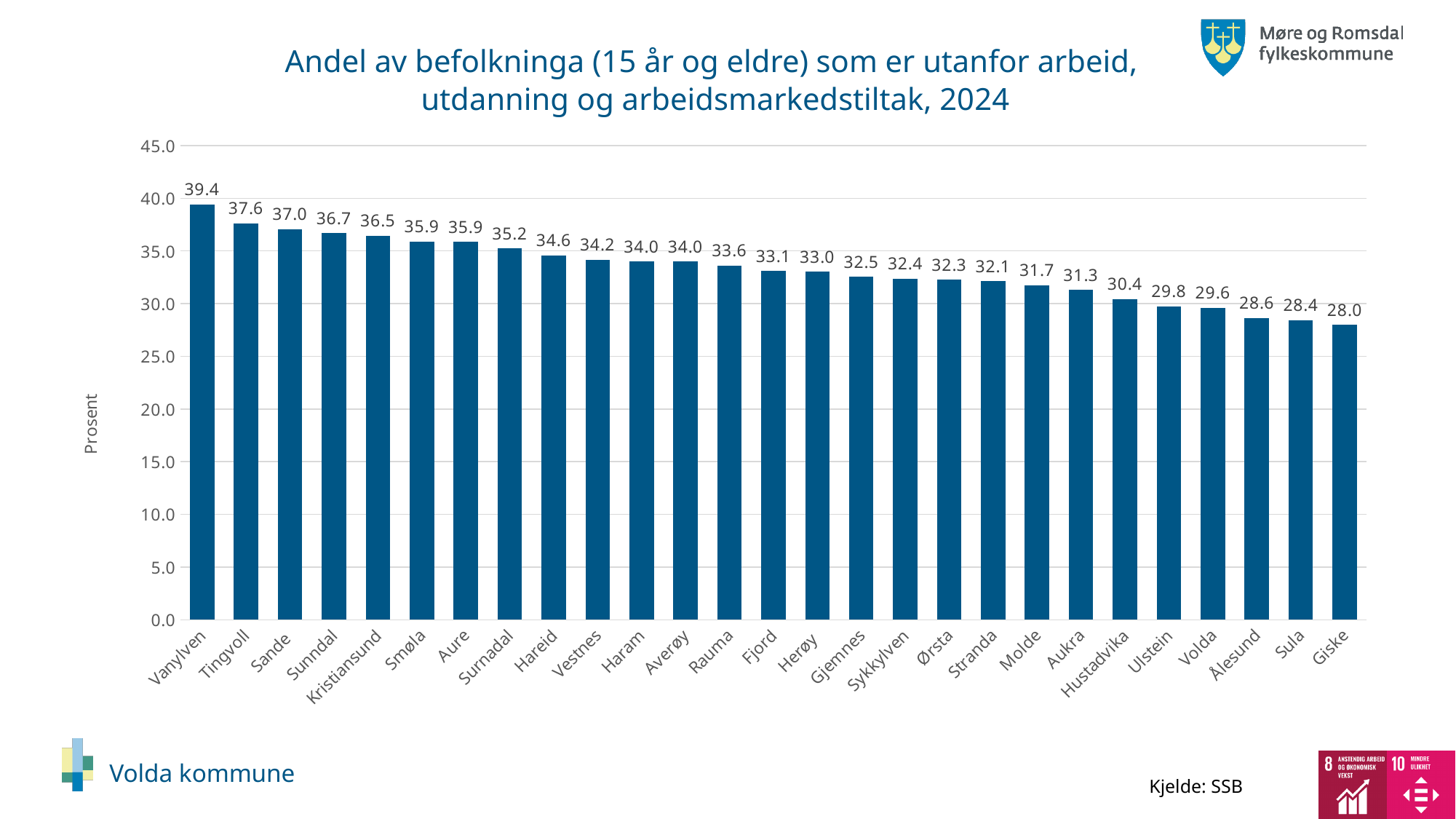
What is the value for Volda? 29.6 Which has a larger value, Tingvoll or Ålesund? Tingvoll Which municipality has the lowest value? Giske Is the value for Hustadvika greater or less than 35.0? less How many municipalities are shown in the chart? 27 What is the value for Molde? 31.7 What is the label on the vertical axis? Prosent What is the value for Kristiansund? 36.5 What is the difference between the values for Ørsta and Volda? 2.7 Which municipality has the highest value? Vanylven What kind of chart is shown on the slide? bar chart What is the difference between the values for Vanylven and Giske? 11.4